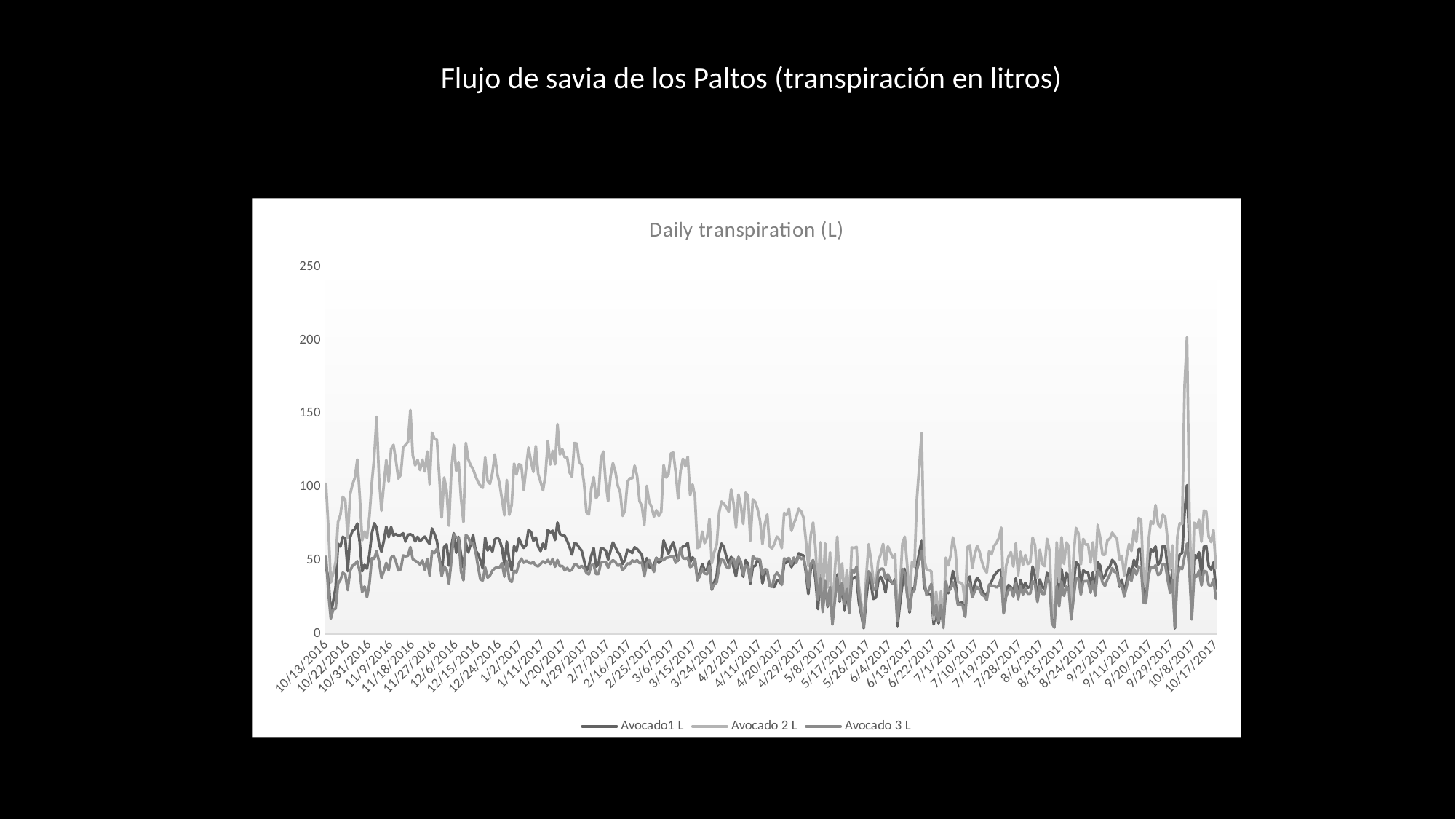
What is the maximum value shown on the vertical axis? 250 What is the title of the chart? Daily transpiration (L) Is the value for Avocado1 L around 11/18/2016 greater or less than 100? less Which series has the highest values during November and December 2016? Avocado 2 L Around 12/6/2016, which series is larger, Avocado 2 L or Avocado 3 L? Avocado 2 L Does the Avocado 2 L series generally rise or fall from 10/13/2016 to 5/17/2017? fall What are the names of the three series in the legend? Avocado1 L, Avocado 2 L, Avocado 3 L What kind of chart is shown on the slide? line chart Is the highest value reached by Avocado 2 L (near 10/8/2017) greater or less than 150? greater How many series does the legend list? 3 Is the value for Avocado 3 L around 11/18/2016 greater or less than 100? less